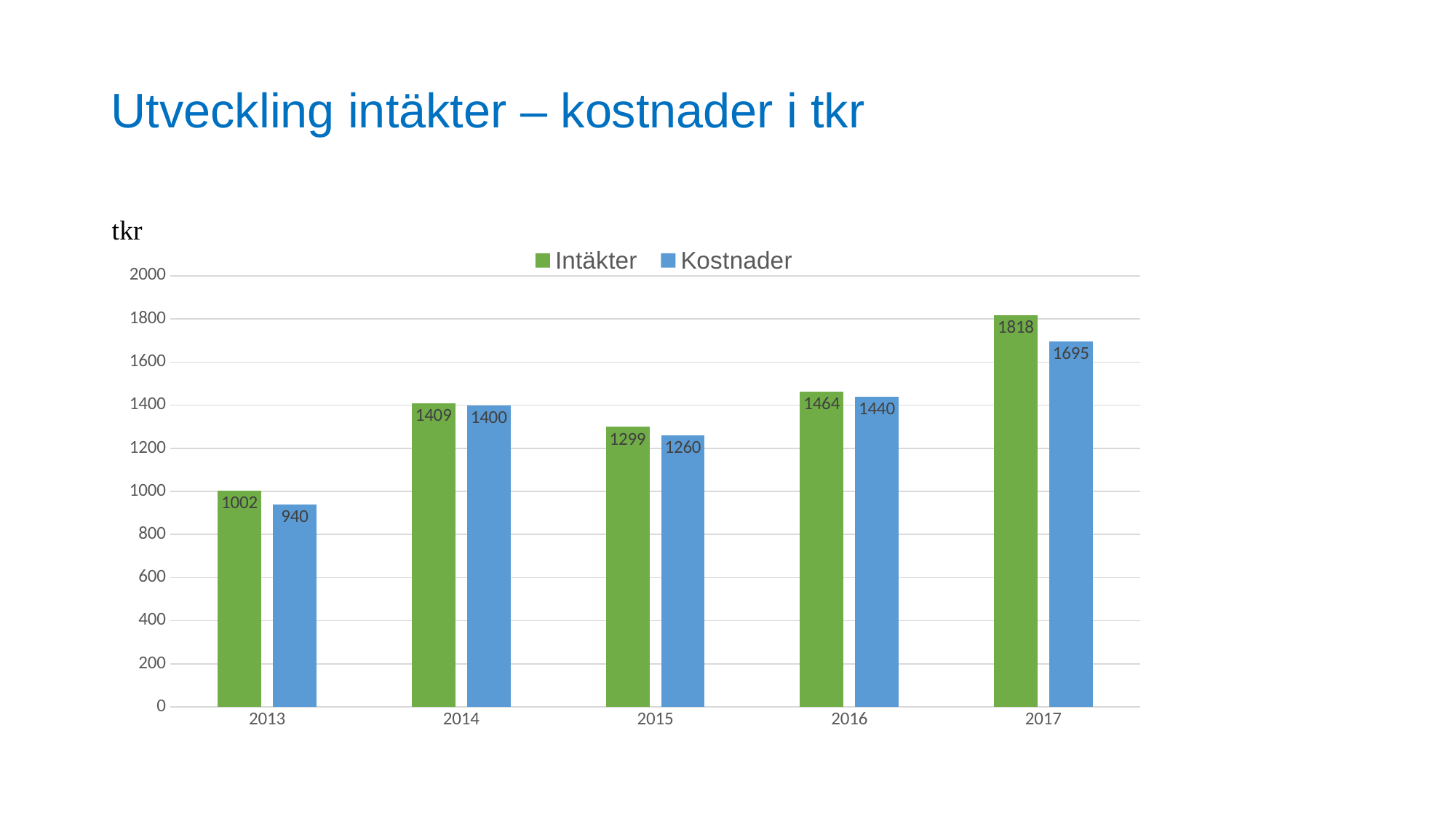
What is the Intäkter value for 2015? 1299 What is the Kostnader value for 2013? 940 How many years are shown on the x axis? 5 What is the difference between Intäkter and Kostnader in 2017? 123 Which colour represents Kostnader in the chart? Blue What kind of chart is shown on the slide? Bar chart Which year has the highest Intäkter value? 2017 What is the Kostnader value for 2017? 1695 Which year has the lowest Kostnader value? 2013 What is the difference between the Intäkter values for 2014 and 2013? 407 Which is larger, Intäkter in 2016 or Kostnader in 2016? Intäkter in 2016 How many series does the legend list? 2